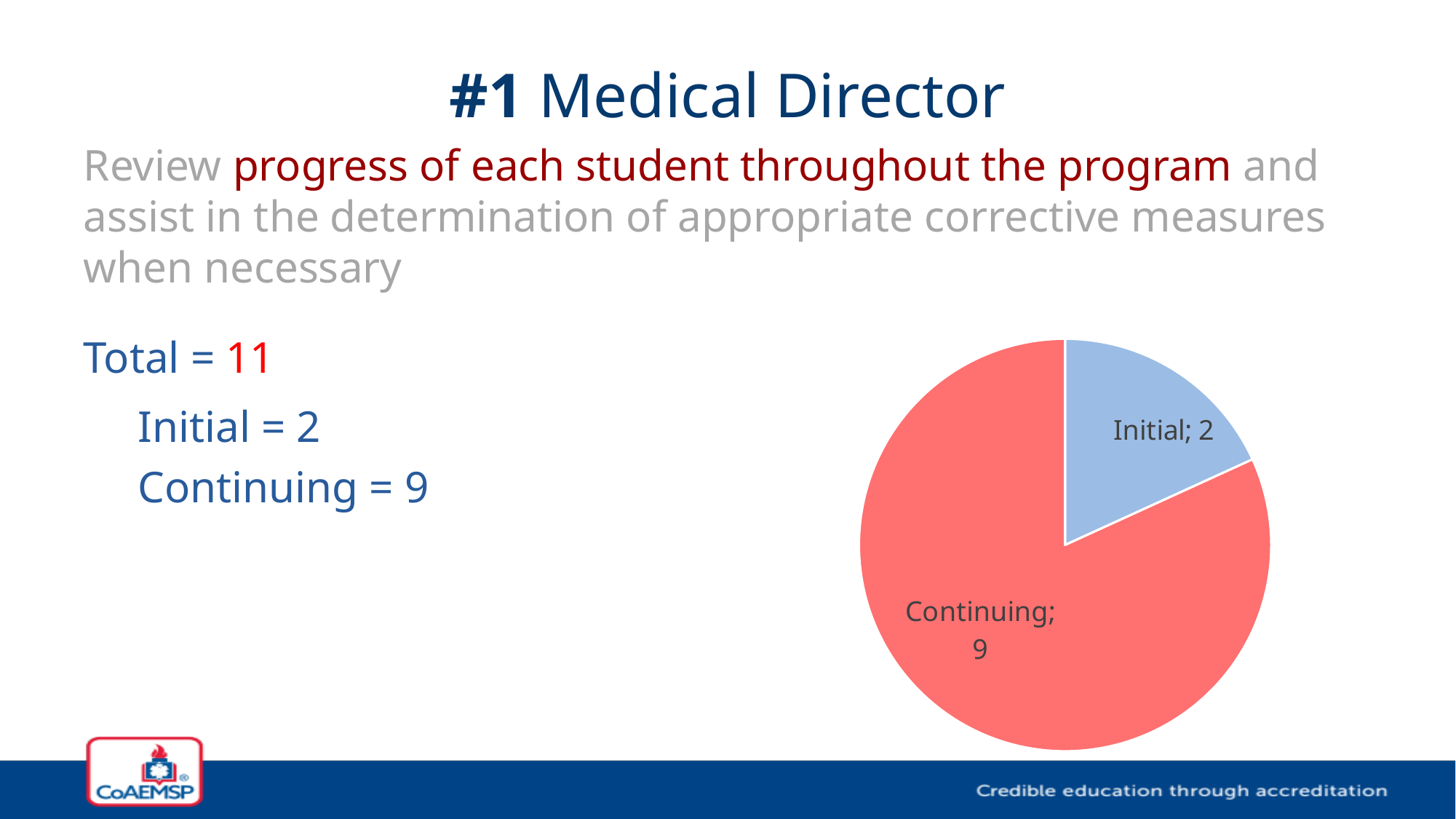
What is the difference between the Continuing and Initial values in the pie chart? 7 Which slice of the pie chart is the smallest? Initial What is the value for Initial in the pie chart? 2 Which is larger in the pie chart, Initial or Continuing? Continuing Which slice of the pie chart is the largest? Continuing What is the total of all slices in the pie chart? 11 What colour is the Continuing slice in the pie chart? red What colour is the Initial slice in the pie chart? light blue What is the value for Continuing in the pie chart? 9 What share of the pie chart does the Continuing slice represent, as a fraction of the total? 9/11 How many slices does the pie chart have? 2 What kind of chart is shown on the slide? pie chart